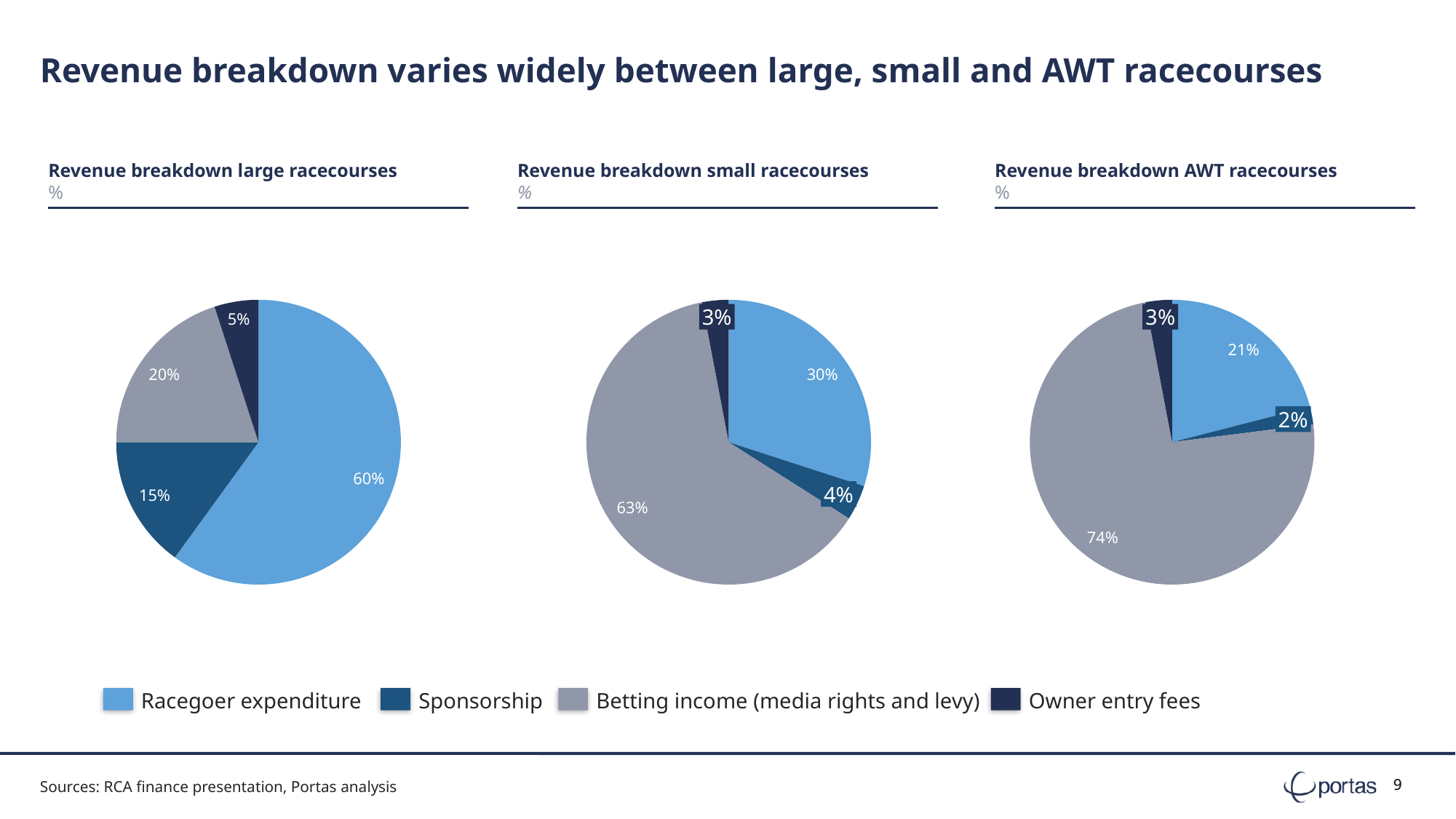
In the 'Revenue breakdown AWT racecourses' chart, what share is Sponsorship? 2% In the 'Revenue breakdown large racecourses' chart, what is the difference between the Racegoer expenditure share and the Betting income share? 40% In the 'Revenue breakdown small racecourses' chart, which category has the smallest share? Owner entry fees What kind of chart is used on this slide? Pie chart How many series does the legend list? 4 In the 'Revenue breakdown AWT racecourses' chart, which category has the smallest share? Sponsorship In the 'Revenue breakdown small racecourses' chart, what share is Betting income (media rights and levy)? 63% How many pie charts are on the slide? 3 In the 'Revenue breakdown AWT racecourses' chart, what share is Owner entry fees? 3% In the 'Revenue breakdown large racecourses' chart, what share is Racegoer expenditure? 60% Which is larger: the Betting income share in the 'Revenue breakdown small racecourses' chart or in the 'Revenue breakdown AWT racecourses' chart? AWT racecourses In the 'Revenue breakdown large racecourses' chart, which category has the largest share? Racegoer expenditure